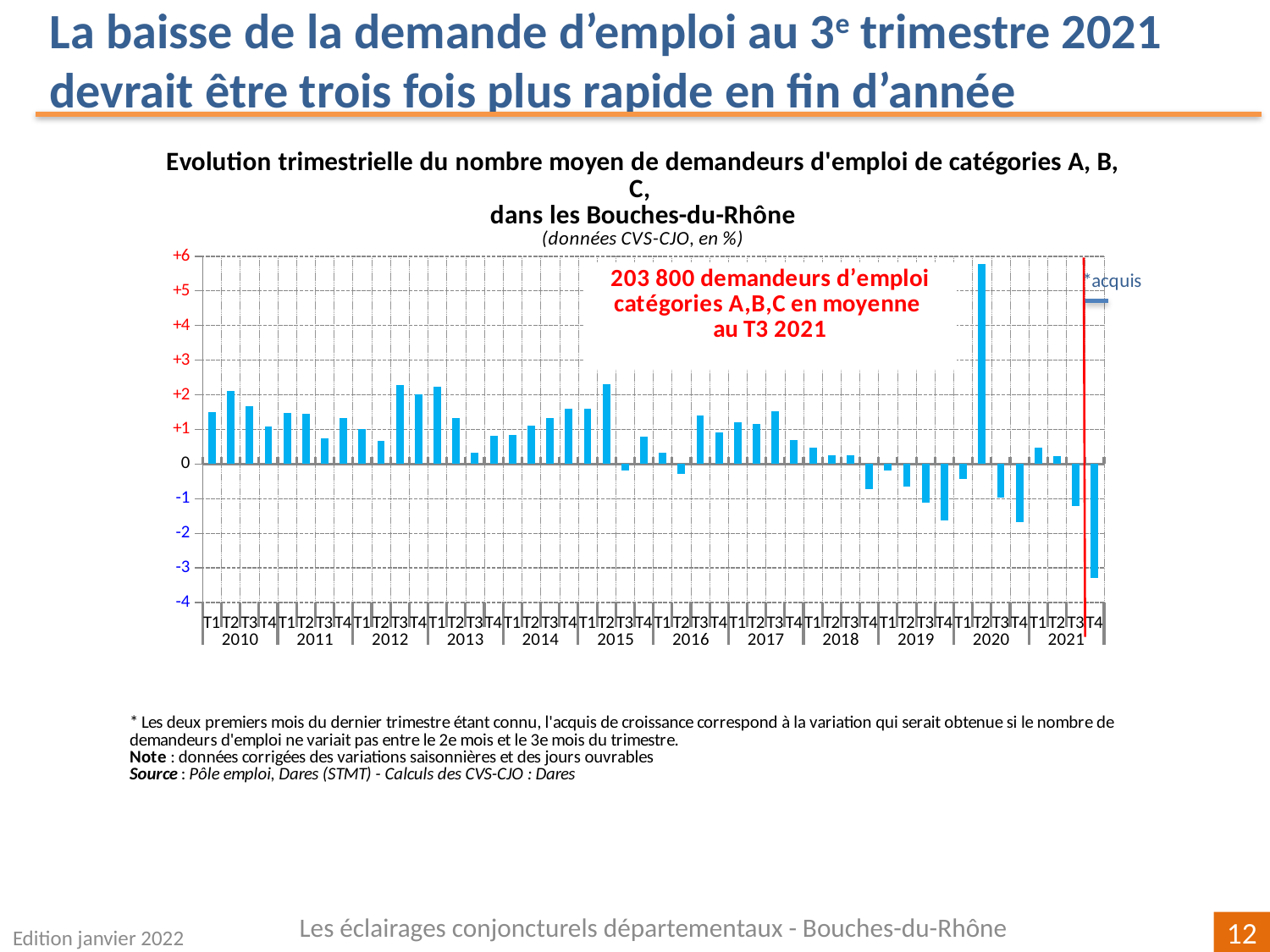
Is the value for T4 2019 greater or less than -1? less Is the value for T2 2012 greater or less than +2? less What unit does the chart subtitle say the data are expressed in? % Which quarter has the lowest value on the chart? T4 2021 Is the value for T4 2021 greater or less than -2? less What kind of chart is shown on the slide? bar chart According to the annotation on the chart, how many job seekers in categories A, B, C were there on average in T3 2021? 203 800 How many years are covered on the x axis of the chart? 12 Which is larger, the value for T2 2020 or the value for T2 2015? T2 2020 Which quarter has the highest value on the chart? T2 2020